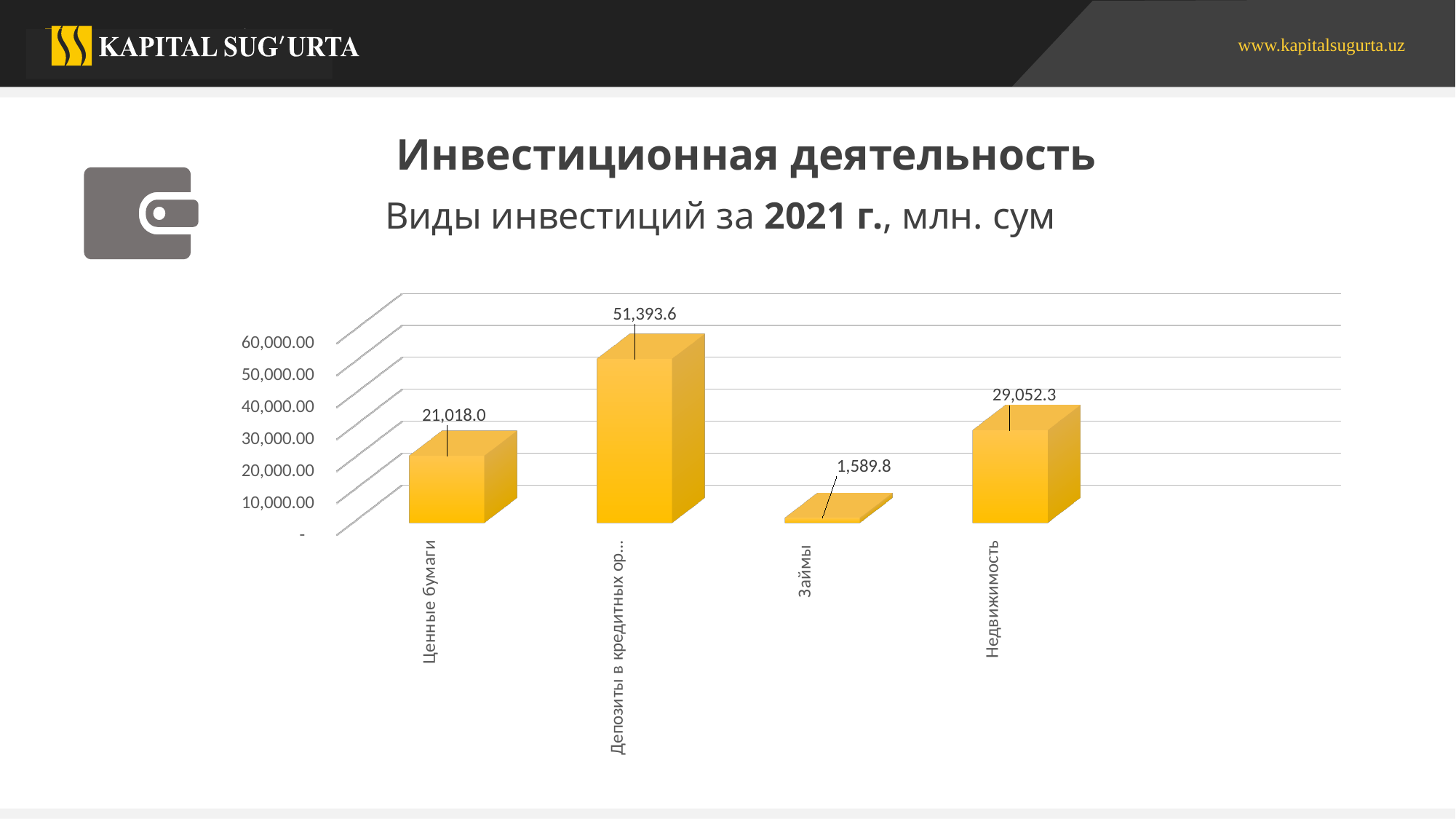
What kind of chart is shown on the slide? Bar chart Which category has the lowest value? Займы How many categories are shown in the chart? 4 Which is larger, the value for Недвижимость or the value for Ценные бумаги? Недвижимость What is the value for Займы? 1,589.8 What is the value for the category labelled Депозиты в кредитных ор...? 51,393.6 What unit is stated in the chart subtitle for the investment values? млн. сум What is the value for Недвижимость? 29,052.3 What is the difference between the values for Депозиты в кредитных ор... and Ценные бумаги? 30,375.6 What is the value for Ценные бумаги? 21,018.0 Which category has the highest value? Депозиты в кредитных ор... What is the difference between the values for Недвижимость and Ценные бумаги? 8,034.3